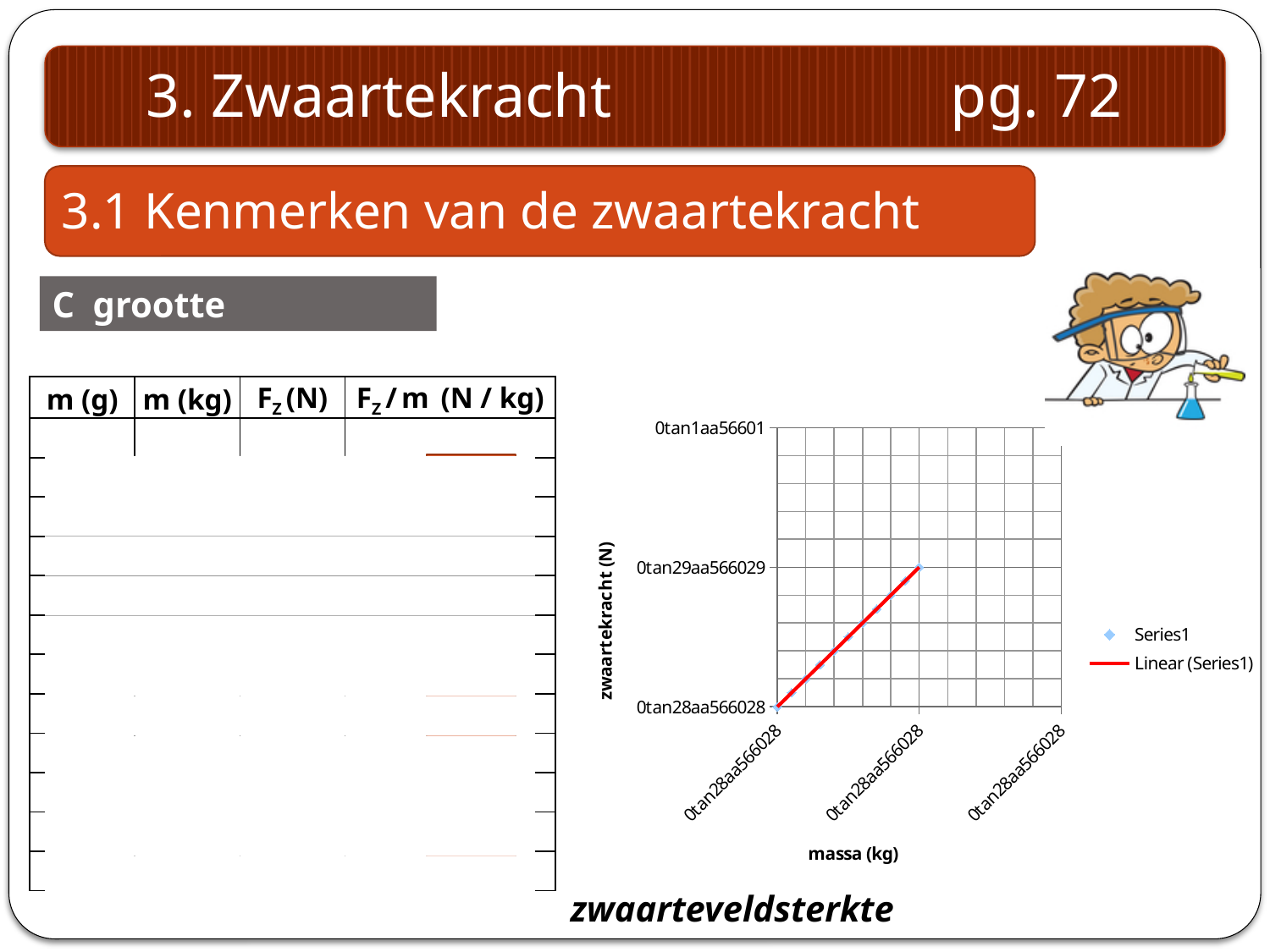
What kind of chart is shown on the slide? scatter chart with a linear trendline How many entries does the chart's legend list? 2 What is the title of the horizontal axis of the chart? massa (kg) Do the plotted values rise or fall as massa (kg) increases along the x axis? rise What is the title of the vertical axis of the chart? zwaartekracht (N)